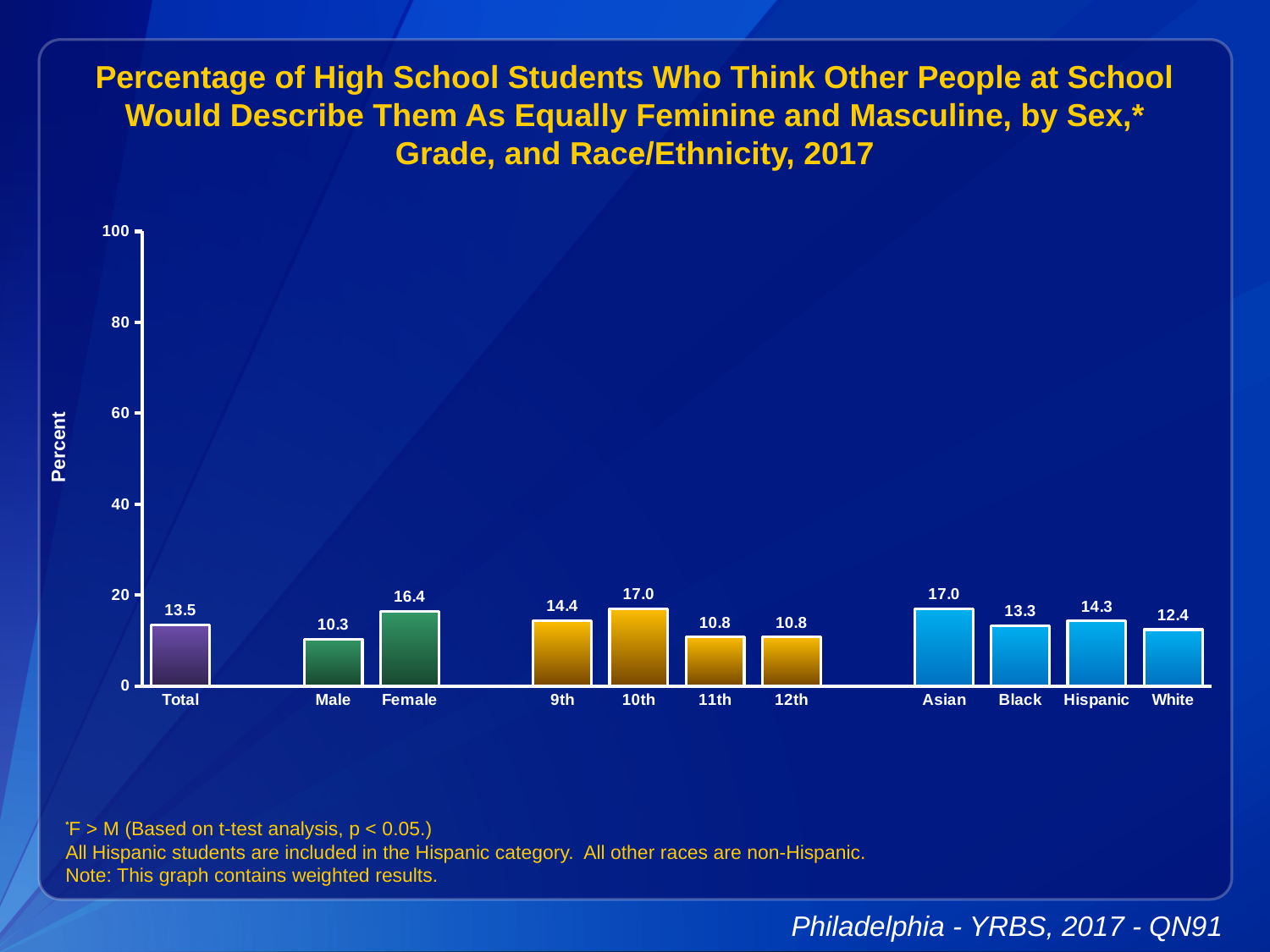
What is the value for Total? 13.5 What kind of chart is shown on the slide? Bar chart What is the label of the y axis? Percent What is the difference between the Asian and White values? 4.6 Which is larger, the value for 9th grade or the value for 12th grade? 9th How many categories are shown on the x axis? 11 What is the value for 11th grade? 10.8 What is the difference between the Female and Male values? 6.1 Which is larger, the value for Black or the value for Hispanic? Hispanic What is the value for Female? 16.4 What is the value for Hispanic? 14.3 Which category has the lowest value? Male